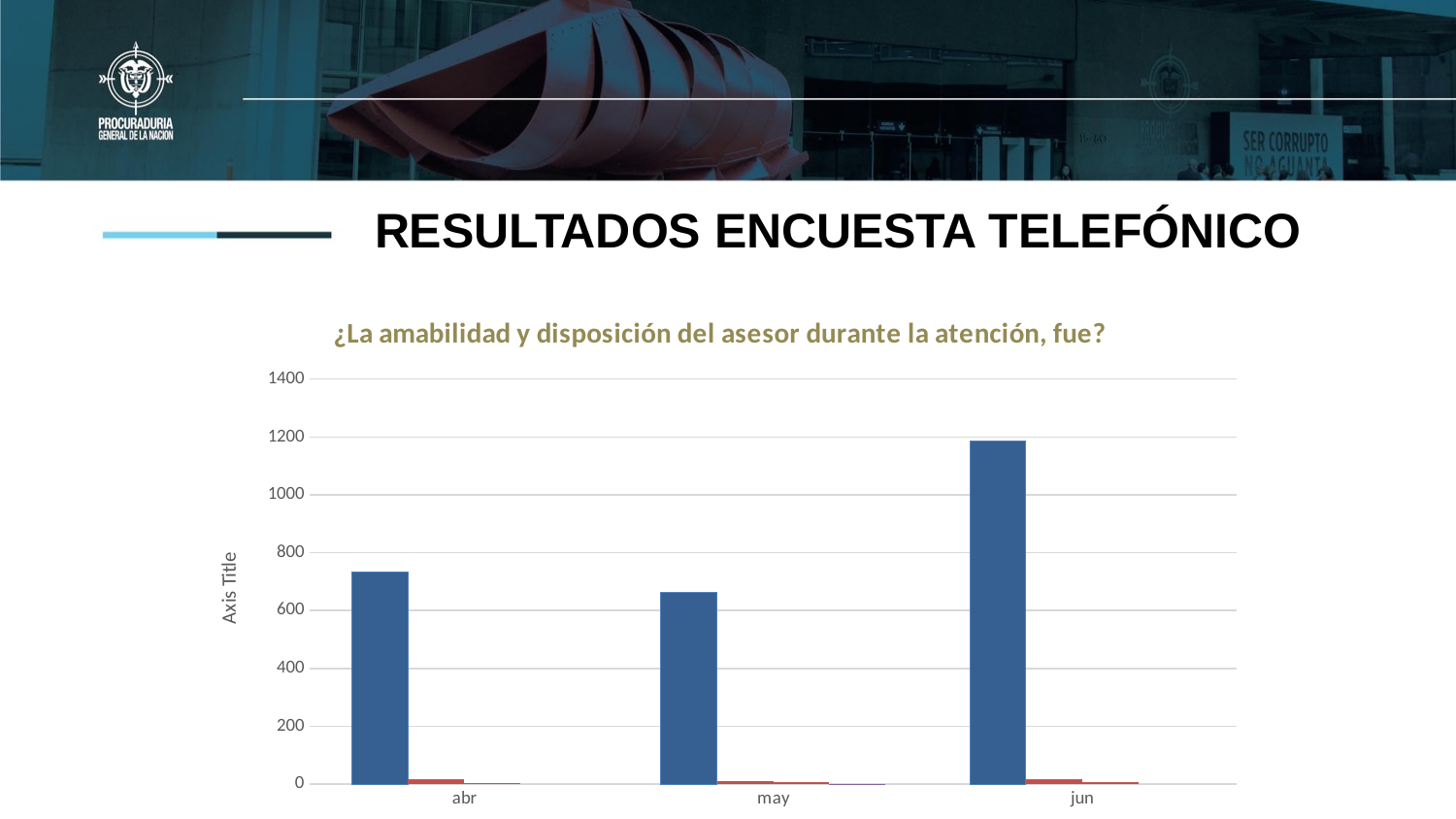
Is the value of the blue bar for abr greater or less than 800? less What is the label on the vertical axis of the chart? Axis Title What kind of chart is shown on the slide? bar chart Which month has the tallest blue bar? jun Is the value of the blue bar for jun greater or less than 1000? greater Which month has the shortest blue bar? may How many categories are shown on the x axis of the chart? 3 Which blue bar is taller, abr or may? abr Is the value of the blue bar for may greater or less than 600? greater Which blue bar is taller, jun or abr? jun What is the title of the chart? ¿La amabilidad y disposición del asesor durante la atención, fue?